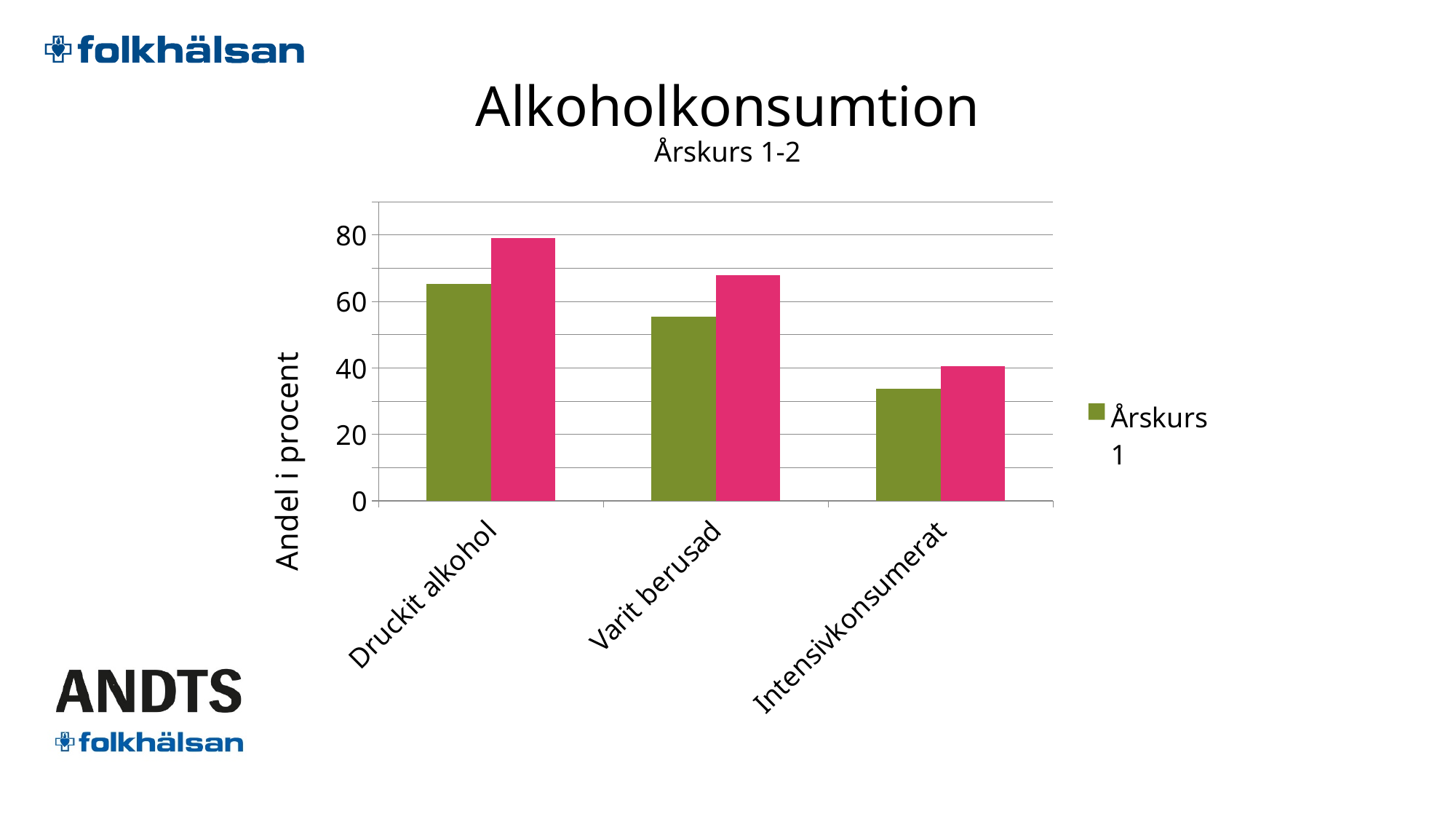
Is the value of the pink bar for Druckit alkohol greater or less than 60? greater Which category has the lowest value for Årskurs 1? Intensivkonsumerat How many series does the chart's legend list? 1 What kind of chart is shown on the slide? bar chart Is the value for Årskurs 1 in Intensivkonsumerat greater or less than 40? less Which category has the highest value for Årskurs 1? Druckit alkohol Is the value for Årskurs 1 in Varit berusad greater or less than 60? less How many categories are shown on the x axis of the chart? 3 Do the Årskurs 1 values rise or fall from Druckit alkohol to Intensivkonsumerat? fall For Druckit alkohol, which bar is taller, the green (Årskurs 1) bar or the pink bar? the pink bar What is the label on the chart's vertical axis? Andel i procent